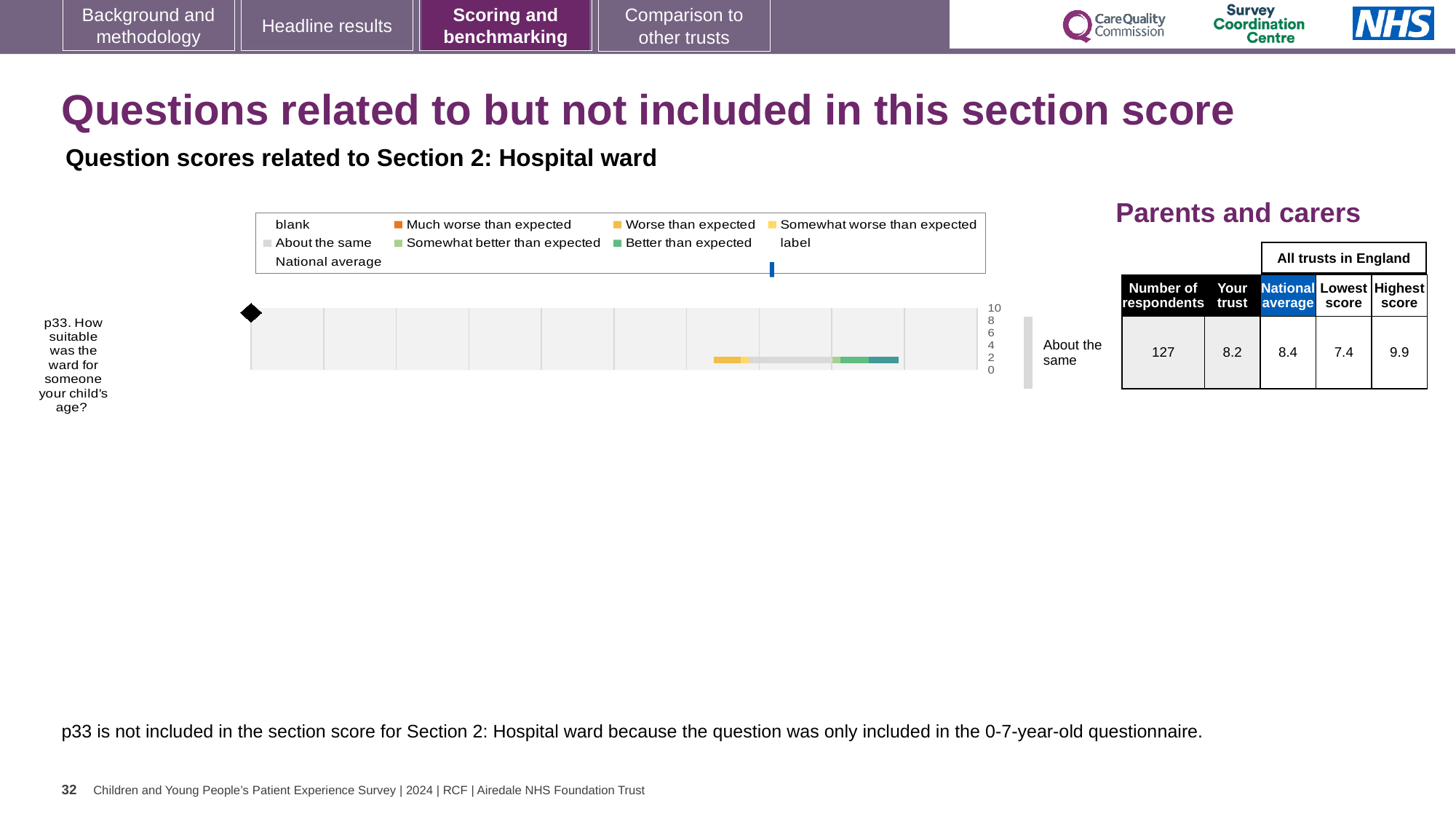
What is the highest value shown on the chart's score axis? 10 For p33, what is the difference between the highest score and the lowest score among all trusts in England? 2.5 For p33, which is larger: the 'Your trust' score or the national average? National average According to the table beside the chart, what is the national average score for p33? 8.4 According to the table beside the chart, how many respondents answered p33? 127 According to the table beside the chart, what is the 'Your trust' score for p33? 8.2 How many questions are plotted in the chart? 1 How many entries does the chart legend list? 9 According to the table beside the chart, what is the highest score among all trusts in England for p33? 9.9 What kind of chart is used to show the p33 question score? bar chart What benchmark label is shown to the right of the bar for p33? About the same According to the table beside the chart, what is the lowest score among all trusts in England for p33? 7.4